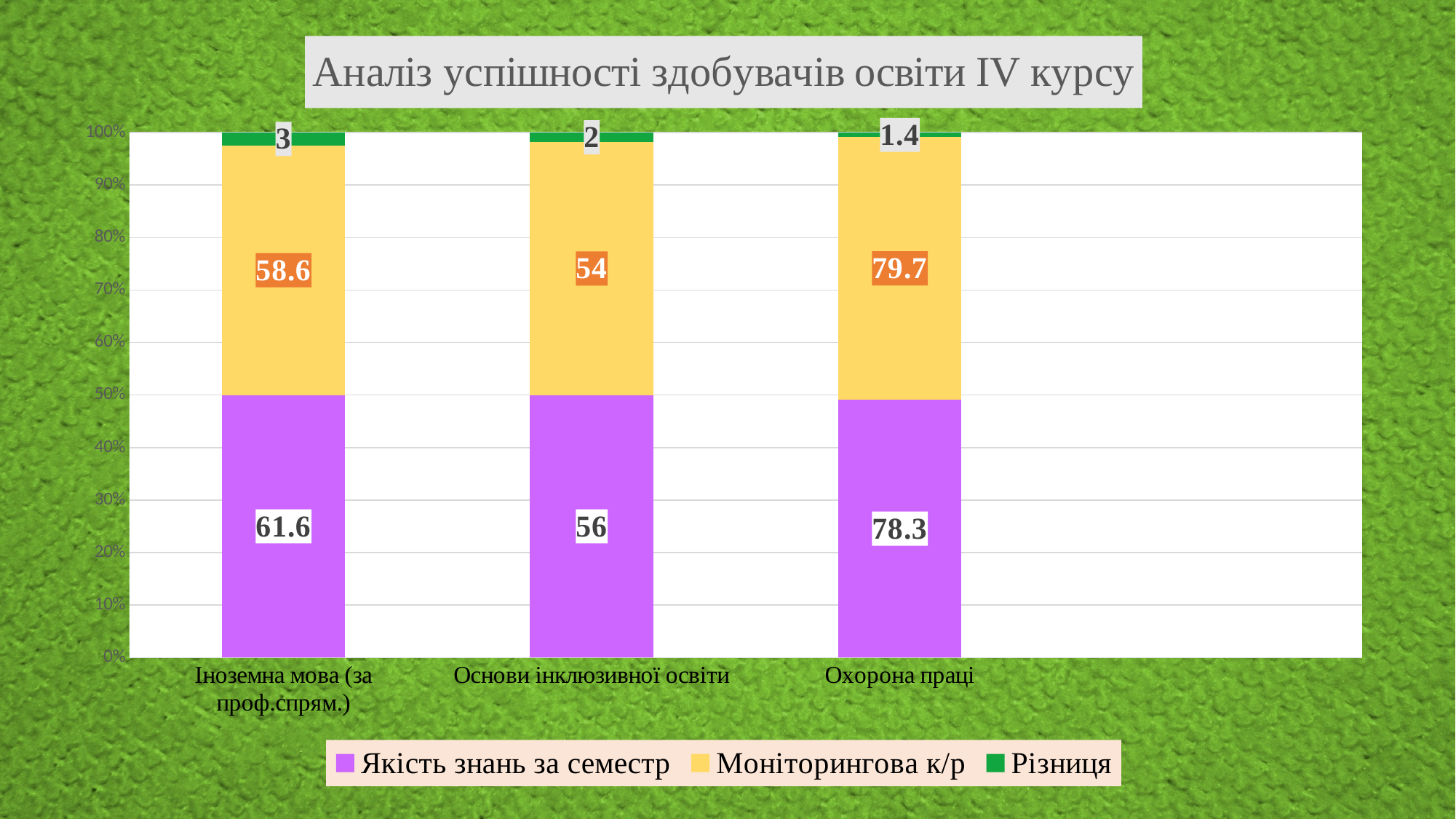
What is the value of Різниця for Іноземна мова (за проф.спрям.)? 3 Which category has the lowest value for Різниця? Охорона праці Which is larger for Іноземна мова (за проф.спрям.): Якість знань за семестр or Моніторингова к/р? Якість знань за семестр What type of chart is shown on the slide? Stacked bar chart Which category has the lowest value for Моніторингова к/р? Основи інклюзивної освіти What is the value of Моніторингова к/р for Основи інклюзивної освіти? 54 What is the value of Моніторингова к/р for Іноземна мова (за проф.спрям.)? 58.6 Which category has the highest value for Якість знань за семестр? Охорона праці How many categories are shown on the x axis? 3 How many series does the legend list? 3 What is the value of Якість знань за семестр for Охорона праці? 78.3 What is the difference between the Якість знань за семестр values for Охорона праці and Основи інклюзивної освіти? 22.3